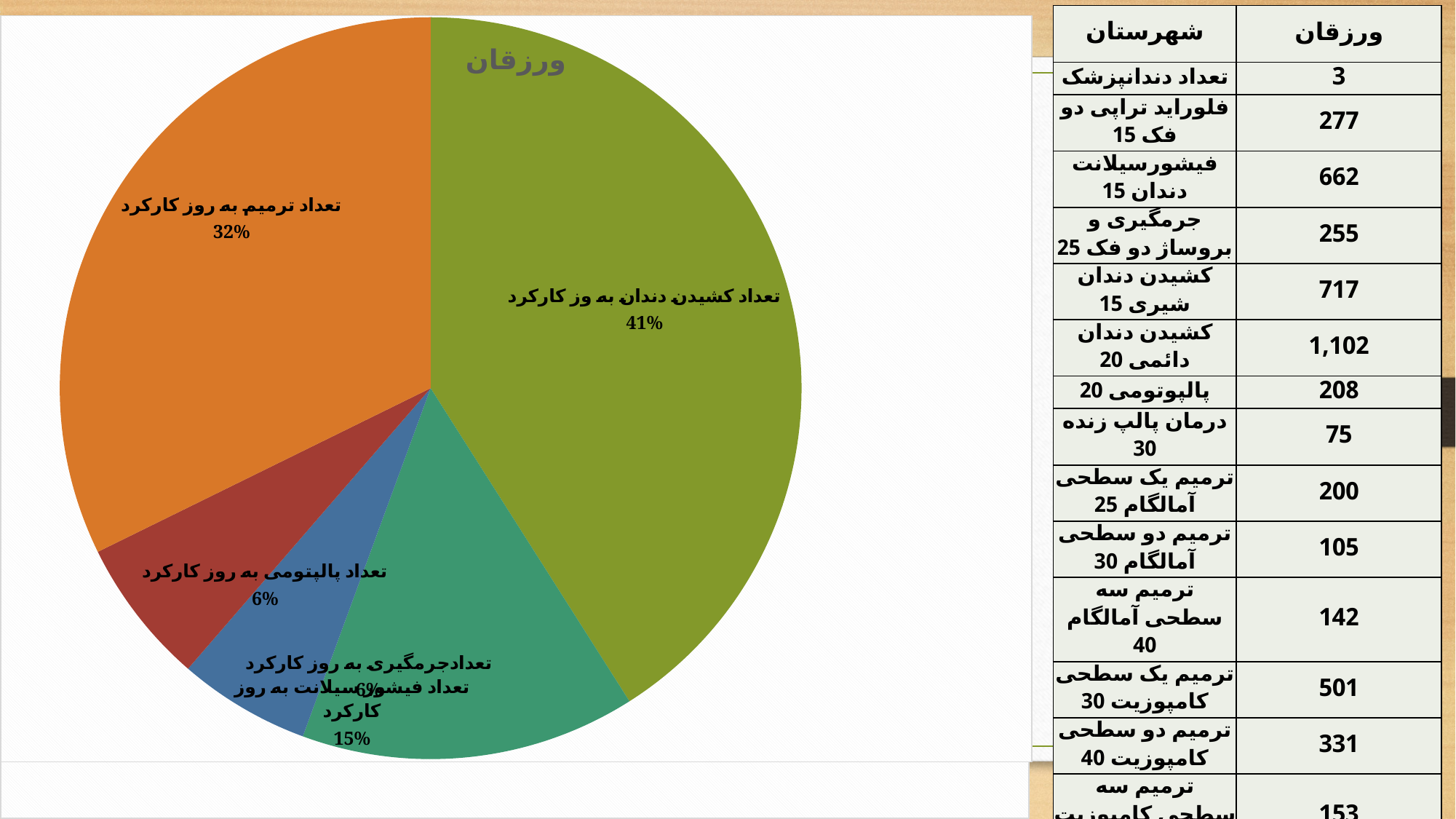
What is the difference in percentage points between تعداد فیشورسیلانت به روز کارکرد and تعداد پالپتومی به روز کارکرد? 9 What share of the pie does تعداد فیشورسیلانت به روز کارکرد have? 15% What is the difference in percentage points between تعداد کشیدن دندان به روز کارکرد and تعداد ترمیم به روز کارکرد? 9 What share of the pie does تعداد ترمیم به روز کارکرد have? 32% What is the title of the pie chart? ورزقان What colour is the slice for تعداد ترمیم به روز کارکرد? orange Which is larger, the slice for تعداد ترمیم به روز کارکرد or the slice for تعداد فیشورسیلانت به روز کارکرد? تعداد ترمیم به روز کارکرد How many slices does the pie chart have? 5 What kind of chart is shown on the slide? pie chart What share of the pie does تعداد پالپتومی به روز کارکرد have? 6% Which category has the largest slice of the pie? تعداد کشیدن دندان به روز کارکرد